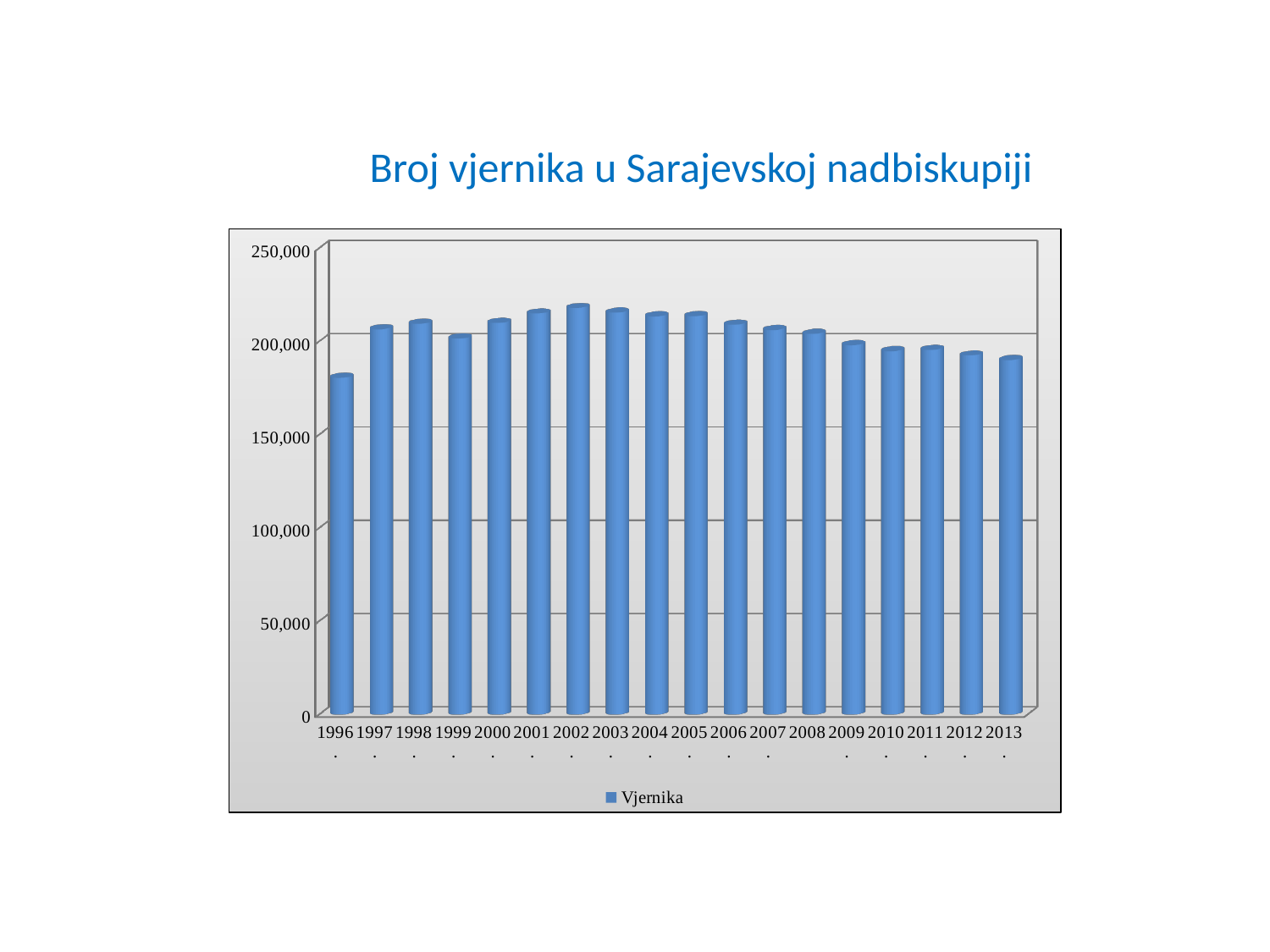
Is the value for 1996 greater or less than 200,000? less How many years are shown on the x axis? 18 Which year has the lowest value? 1996 How many series does the legend list? 1 Which is larger, the value for 1996 or the value for 2013? 2013 Which year has the highest value? 2002 Is the value for 2002 greater or less than 200,000? greater Do the values rise or fall from 2002 to 2013? fall Is the value for 2013 greater or less than 200,000? less What is the title of the chart? Broj vjernika u Sarajevskoj nadbiskupiji What is the name of the series shown in the legend? Vjernika What kind of chart is shown on the slide? Bar chart